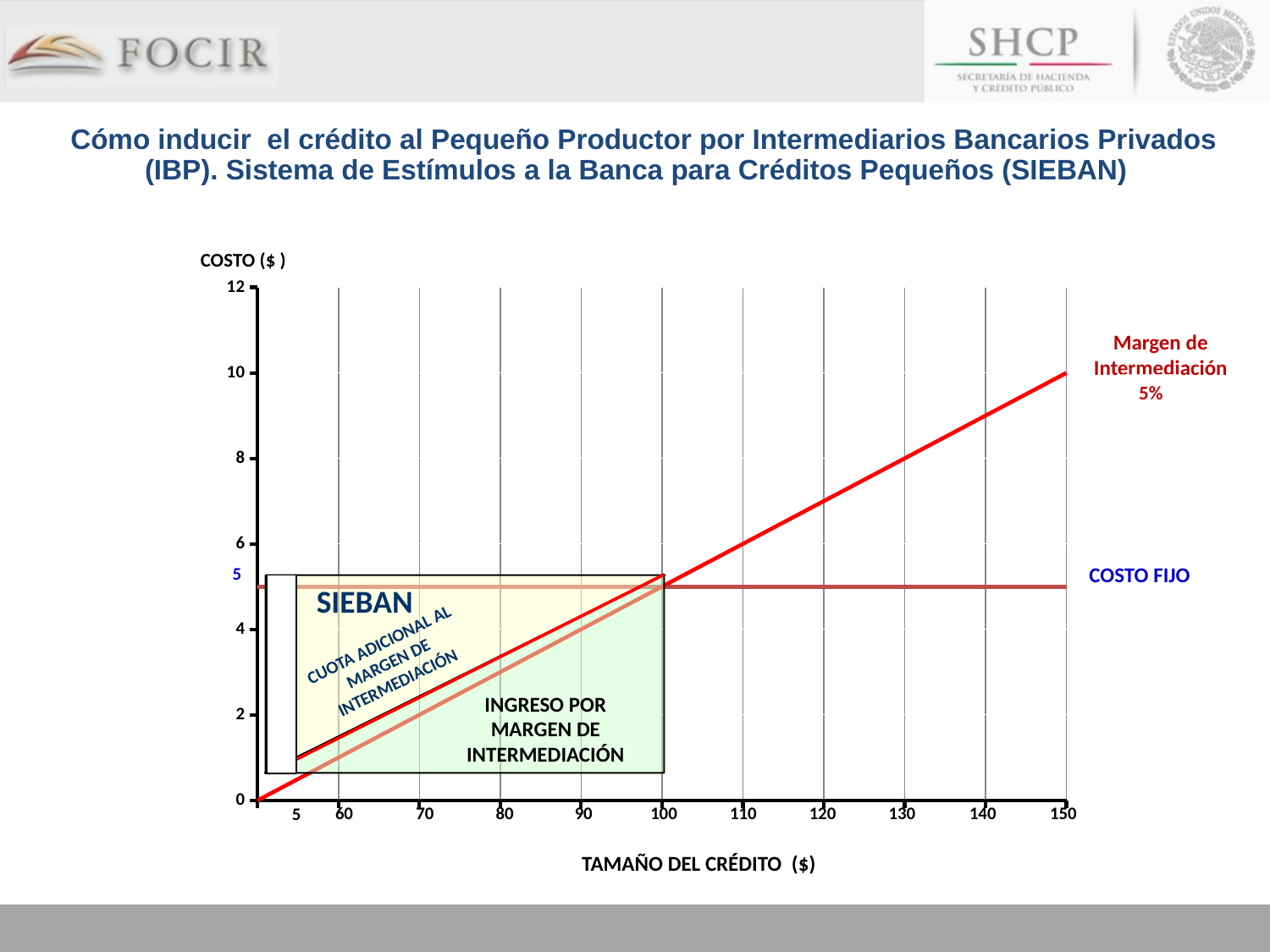
Is the value of the Margen de Intermediación line at a credit size of 60 greater or less than 2? less At a credit size of 120, which line is higher: Margen de Intermediación or COSTO FIJO? Margen de Intermediación Is the value of the Margen de Intermediación line at a credit size of 150 greater or less than 8? greater What kind of chart is shown on the slide? line chart How many tick labels are shown on the horizontal axis? 11 At a credit size of 70, which line is higher: Margen de Intermediación or COSTO FIJO? COSTO FIJO At what cost level does the COSTO FIJO line sit? 5 What is the label of the horizontal axis of the chart? TAMAÑO DEL CRÉDITO ($) What is the highest value shown on the vertical axis? 12 At what credit size does the Margen de Intermediación line cross the COSTO FIJO line? 100 What percentage is stated in the label of the rising red line? 5% Does the Margen de Intermediación line rise or fall as the credit size increases? rises